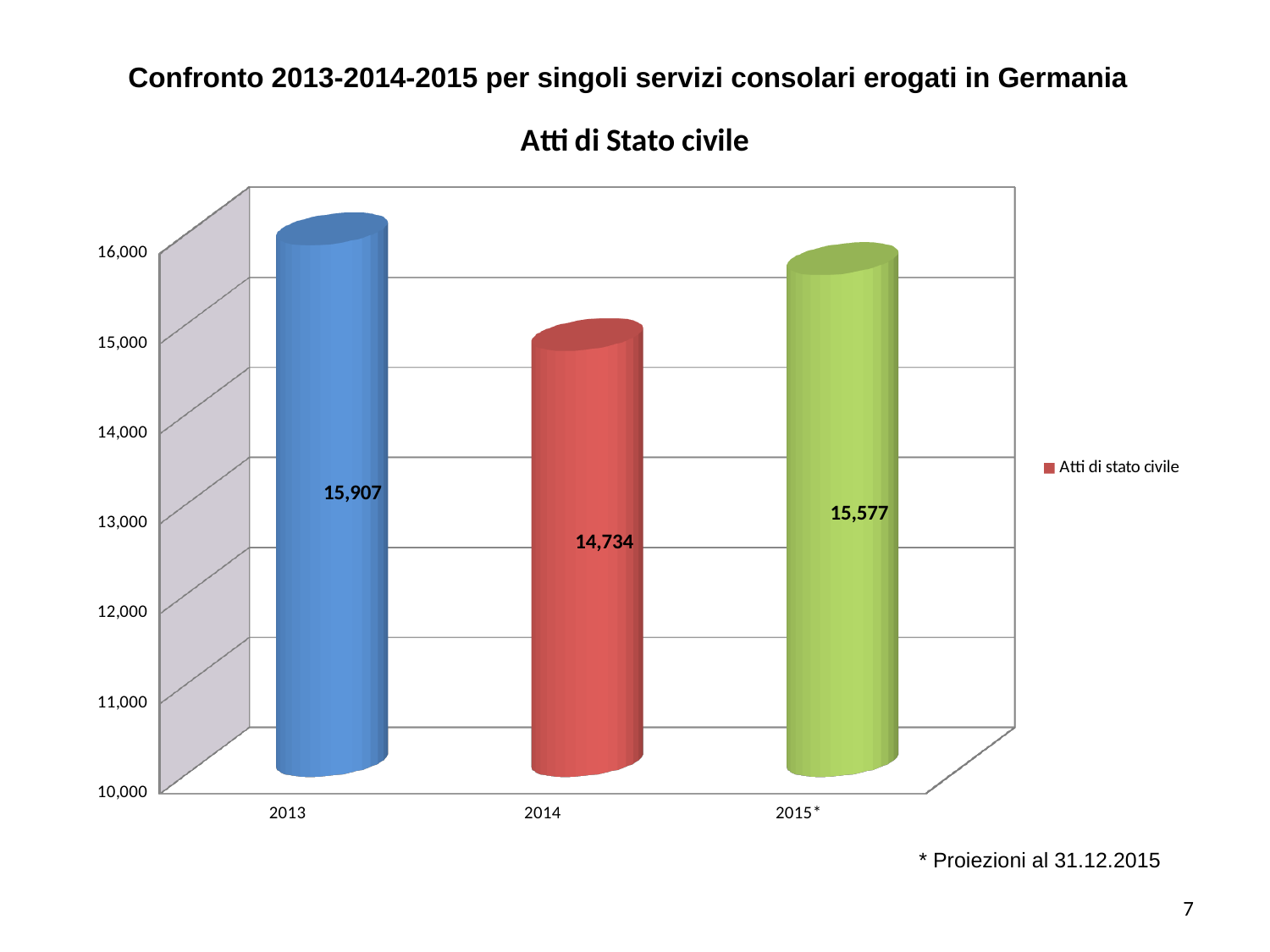
Which year has the lowest value? 2014 Is the value for 2014 greater or less than 15,000? less Which is larger, the value for 2013 or the value for 2015*? 2013 What is the difference between the values for 2015* and 2014? 843 How many years are shown on the x axis? 3 What is the value for 2014? 14,734 What is the difference between the values for 2013 and 2014? 1,173 What is the title of the chart? Atti di Stato civile What is the value for 2013? 15,907 What is the value for 2015*? 15,577 Which year has the highest value? 2013 What kind of chart is this? bar chart